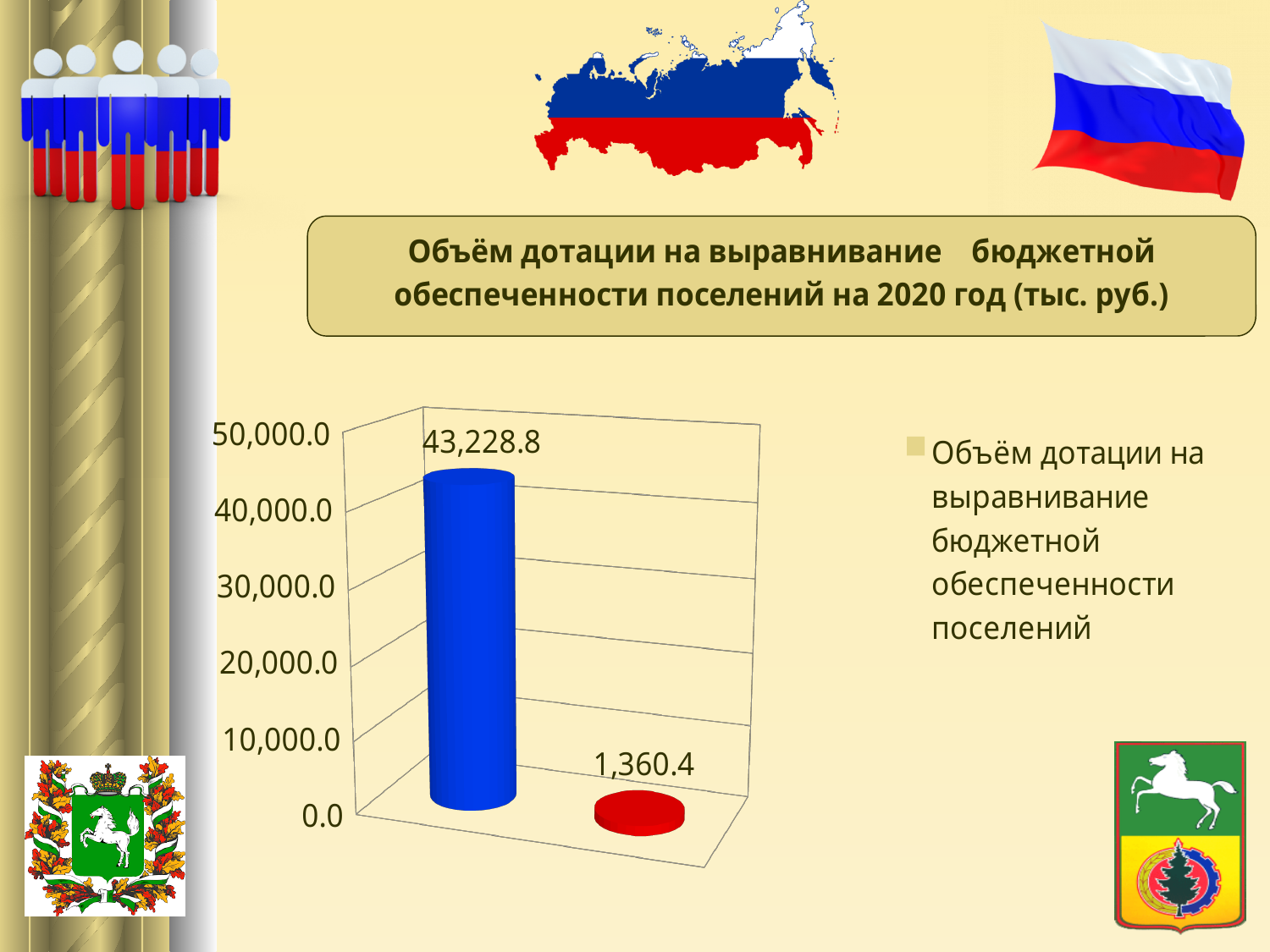
Which bar shows the lowest value, the blue one or the red one? the red bar Is the value of the blue bar greater or less than 40,000.0? greater What value is printed above the red bar? 1,360.4 What is the difference between the blue bar's value and the red bar's value? 41,868.4 What value is printed above the blue bar? 43,228.8 How many bars are plotted in the chart? 2 Is the value of the red bar greater or less than 10,000.0? less How many entries does the legend list? 1 What is the highest value shown on the vertical axis? 50,000.0 Which bar shows the highest value, the blue one or the red one? the blue bar In what unit are the values in the chart expressed, according to the title? тыс. руб. What kind of chart is shown on the slide? bar chart